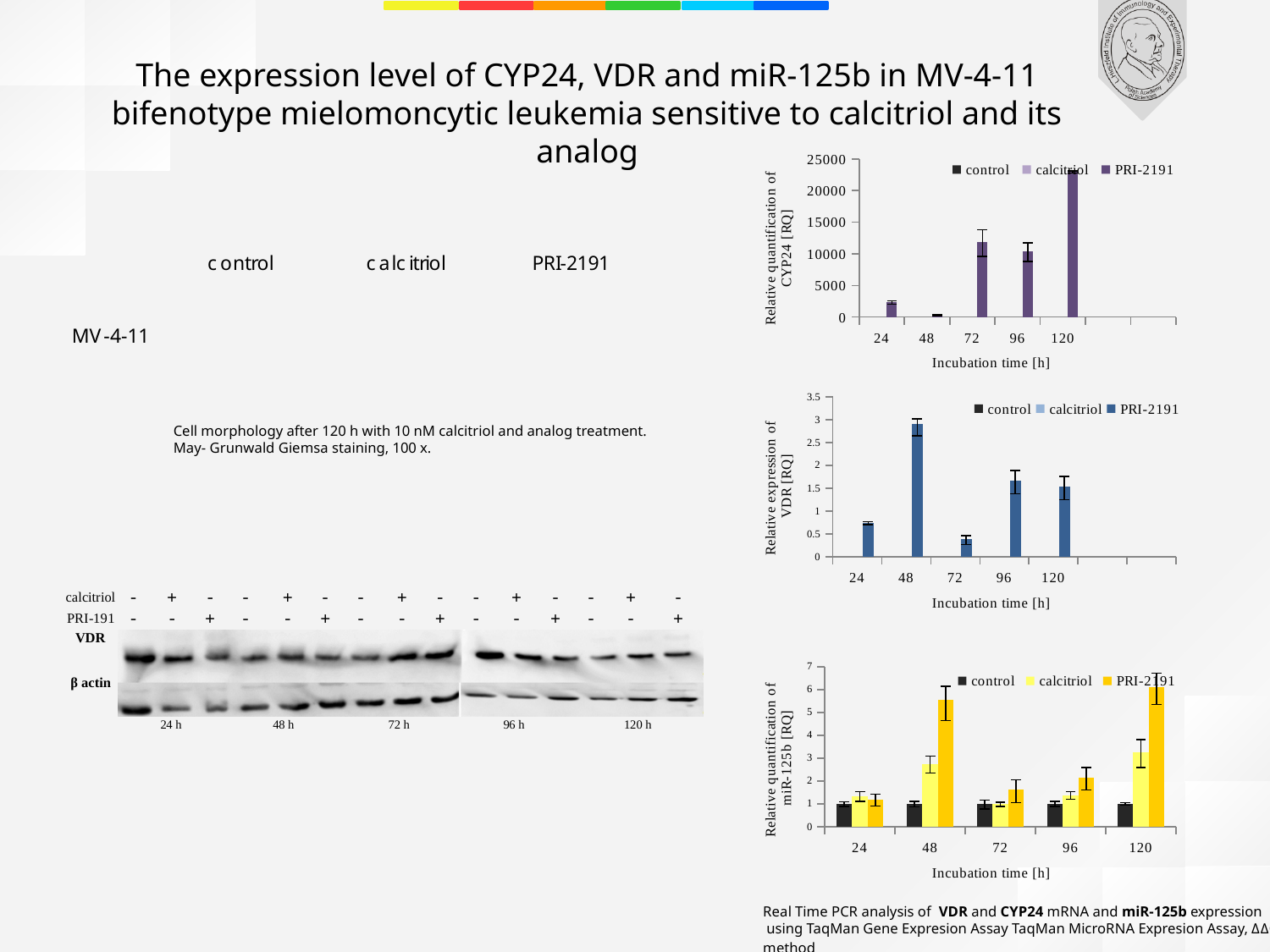
How many series does the legend of the CYP24 chart list? 3 In the CYP24 chart, is the PRI-2191 value at 120 h greater or less than 20000? greater In the VDR chart, is the PRI-2191 value at 48 h greater or less than 2.5? greater In the VDR chart, at which incubation time is the PRI-2191 bar highest? 48 In the miR-125b chart, at 48 h, which is larger: the calcitriol bar or the PRI-2191 bar? PRI-2191 In the CYP24 chart, at which incubation time is the PRI-2191 bar highest? 120 What is the x-axis title of the miR-125b chart? Incubation time [h] How many incubation time categories are shown on the x axis of the VDR chart? 5 What kind of chart is the top-right chart showing relative quantification of CYP24? bar chart In the CYP24 chart, is the PRI-2191 value at 24 h greater or less than 5000? less In the VDR chart, at which incubation time is the PRI-2191 bar lowest? 72